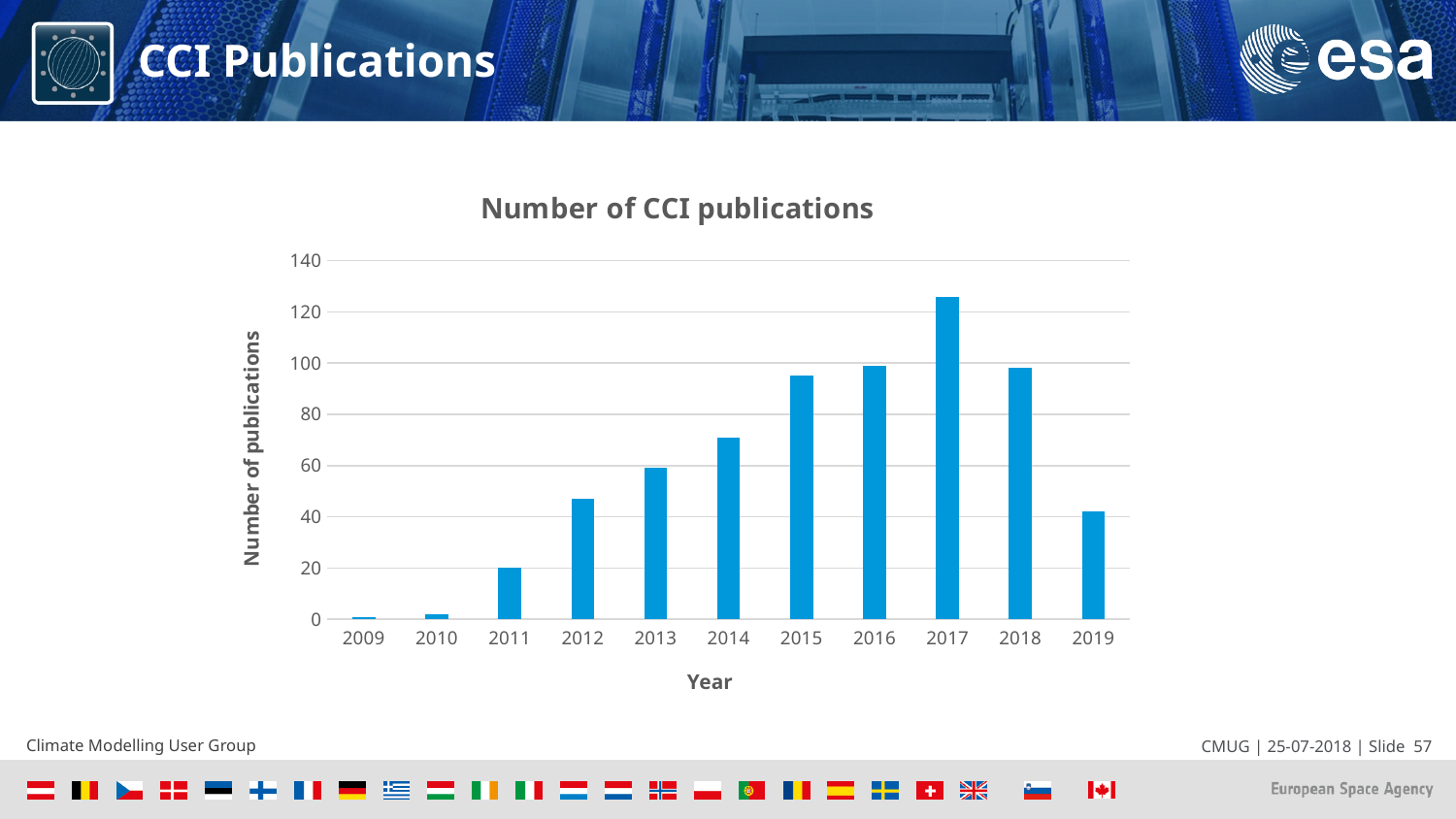
How many years are shown on the x axis of the chart? 11 What type of chart is shown on the slide? Bar chart Which year has more publications, 2014 or 2015? 2015 Which year has the highest number of CCI publications? 2017 What is the number of CCI publications in 2011? 20 Is the number of publications in 2019 greater or less than 60? less What is the label of the vertical axis? Number of publications Is the number of publications in 2014 greater or less than 60? greater Is the number of publications in 2017 greater or less than 120? greater What is the title of the chart? Number of CCI publications Do the number of publications rise or fall from 2009 to 2017? rise